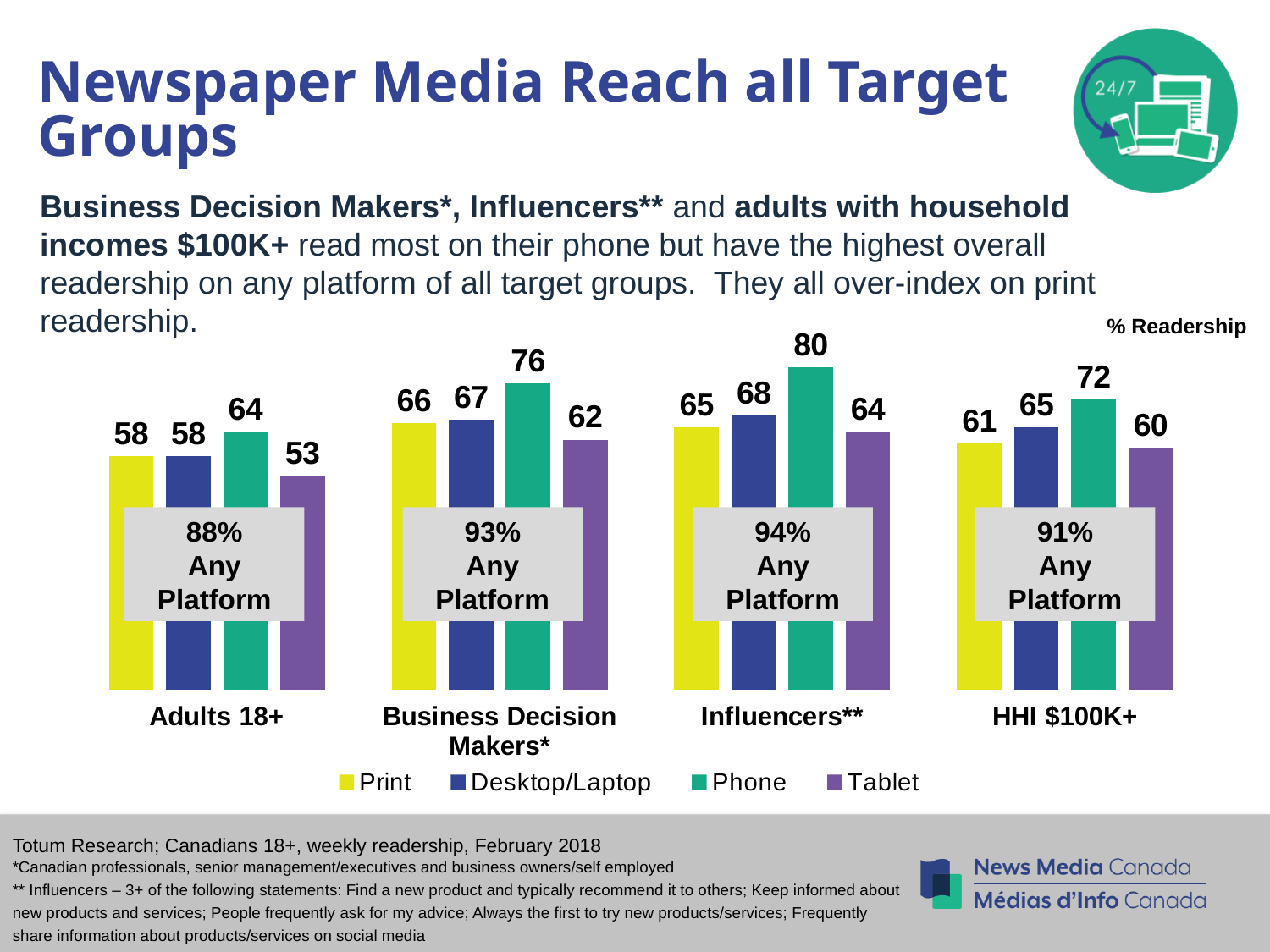
What is the Desktop/Laptop readership value for HHI $100K+? 65 Which target group has the lowest Tablet readership? Adults 18+ What is the Phone readership value for Influencers**? 80 Which target group has the highest Phone readership? Influencers** What is the Tablet readership value for Adults 18+? 53 How many target groups are shown on the x axis? 4 What is the 'Any Platform' readership shown for Influencers**? 94% What kind of chart is shown on the slide? Bar chart Which is larger for HHI $100K+: the Phone value or the Tablet value? Phone What is the Print readership value for Business Decision Makers*? 66 What is the difference between the Phone and Print readership values for Business Decision Makers*? 10 How many series does the legend list? 4